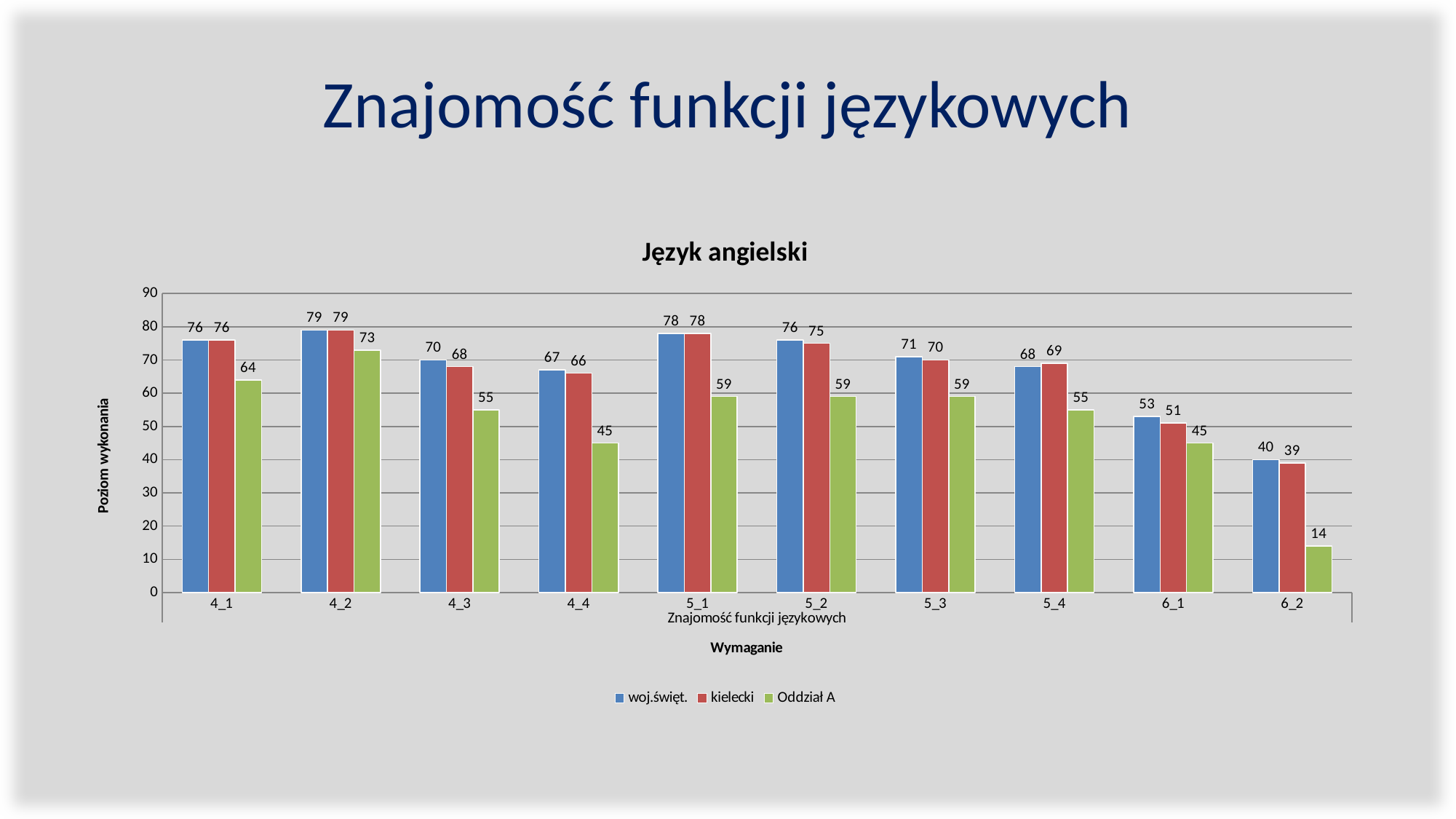
What is the title of the chart? Język angielski Which category has the lowest value for Oddział A? 6_2 How many series does the legend list? 3 What is the value for Oddział A at category 6_2? 14 What kind of chart is shown? bar chart Which category has the highest value for woj.święt.? 4_2 What is the value for woj.święt. at category 4_2? 79 What is the label of the vertical axis? Poziom wykonania What is the value for kielecki at category 5_4? 69 Which is larger at category 6_1: the value for woj.święt. or the value for kielecki? woj.święt. What is the difference between the woj.święt. and Oddział A values at category 4_4? 22 How many categories are shown on the x axis? 10